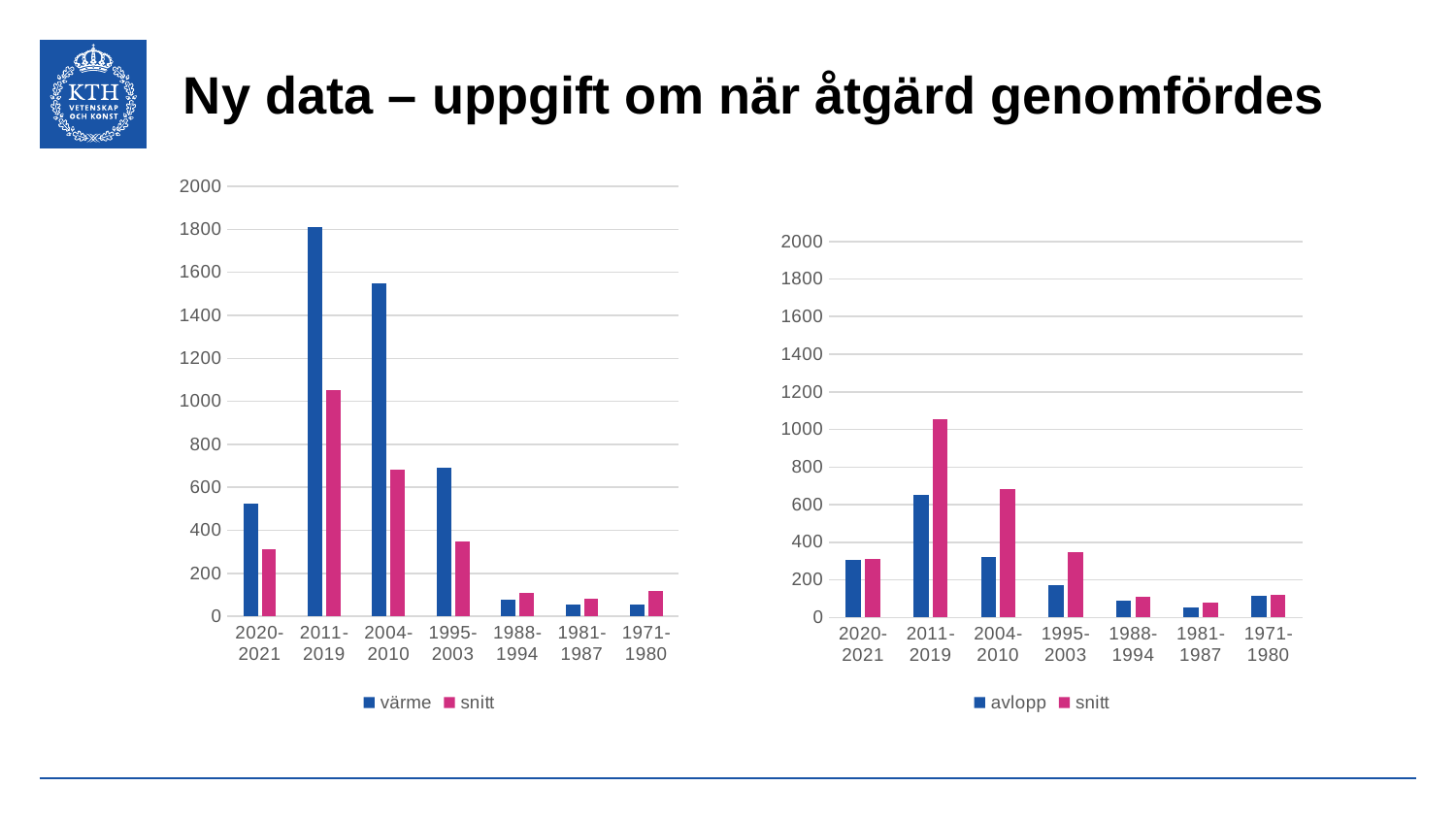
In the left chart, which category has the highest värme value? 2011-2019 What are the legend entries of the left chart? värme, snitt What are the legend entries of the right chart? avlopp, snitt How many series does the legend of the left chart list? 2 How many year-range categories are shown on the x axis of the left chart? 7 In the right chart, which is larger for 2011-2019: avlopp or snitt? snitt In the right chart, which category has the highest avlopp value? 2011-2019 In the left chart, is the värme value for 2011-2019 greater or less than 1600? greater What kind of chart is the chart on the left of the slide? bar chart In the right chart, which category has the lowest avlopp value? 1981-1987 In the left chart, which is larger for 2004-2010: värme or snitt? värme In the left chart, is the snitt value for 2020-2021 greater or less than 400? less